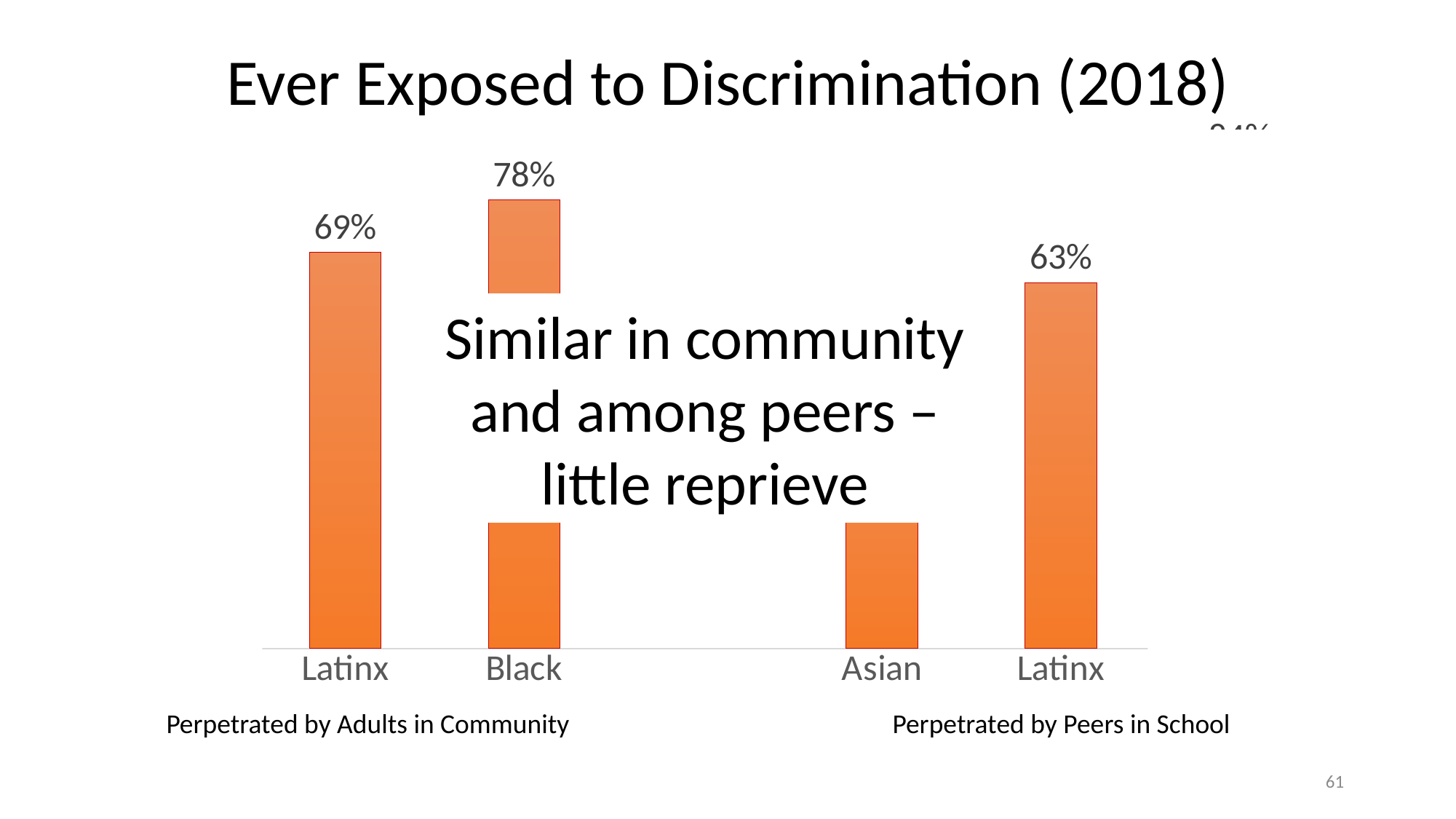
Which is larger, the Latinx value under Perpetrated by Adults in Community or the Latinx value under Perpetrated by Peers in School? Perpetrated by Adults in Community Which is larger, the value for Black or the value for Latinx under Perpetrated by Adults in Community? Black What is the difference between the Black value and the Latinx value under Perpetrated by Adults in Community? 9 percentage points What is the difference between the Latinx value under Perpetrated by Adults in Community and the Latinx value under Perpetrated by Peers in School? 6 percentage points What kind of chart is shown on the slide? Bar chart How many bars are plotted in the chart? 4 What is the title of the chart? Ever Exposed to Discrimination (2018) What is the value for Black under Perpetrated by Adults in Community? 78% What are the two group labels shown beneath the chart? Perpetrated by Adults in Community; Perpetrated by Peers in School What is the value for Latinx under Perpetrated by Adults in Community? 69% What is the value for Latinx under Perpetrated by Peers in School? 63%